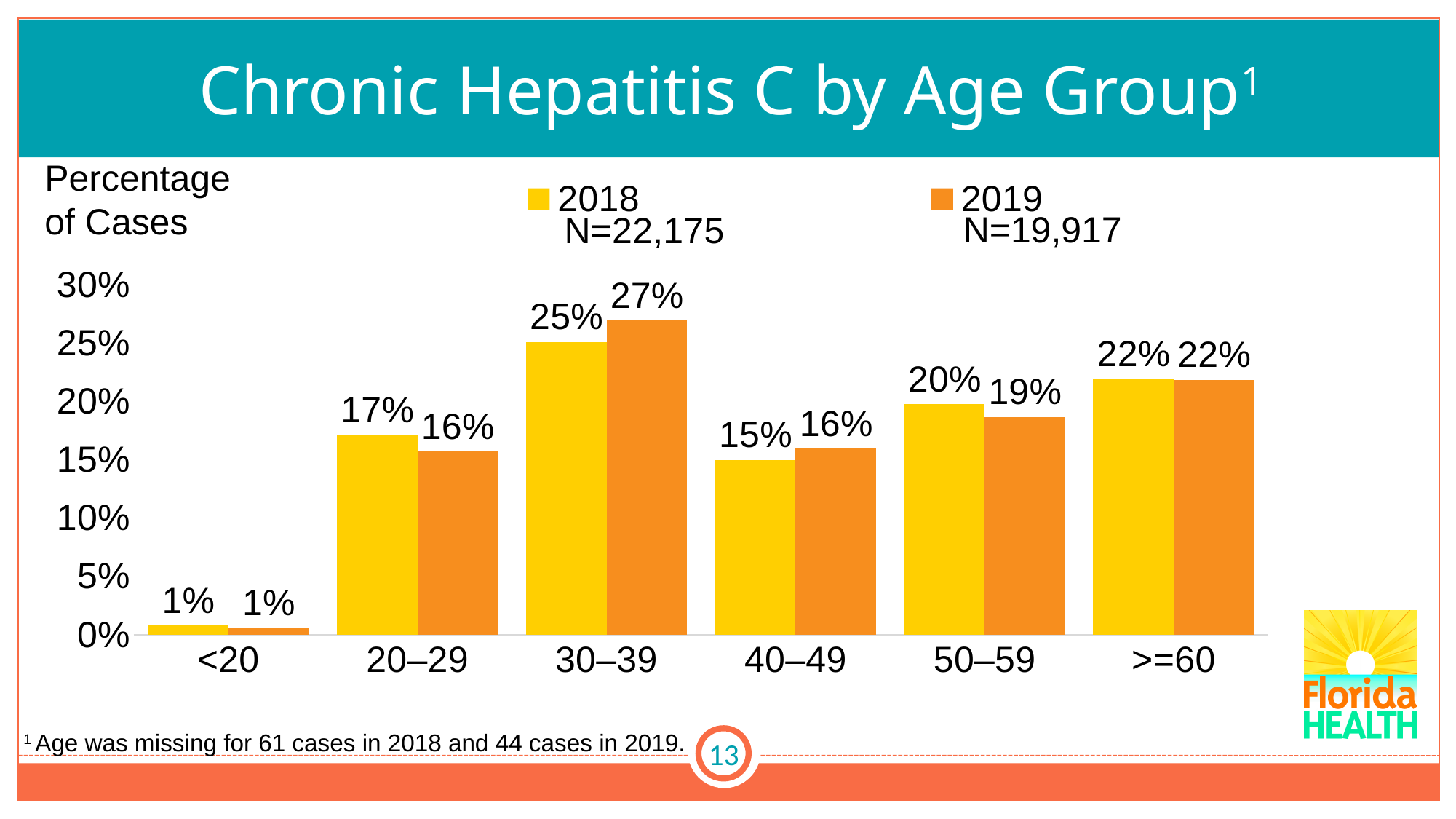
What is the difference between the 2019 and 2018 percentages for the 30–39 age group? 2% What percentage of cases were in the 50–59 age group in 2018? 20% What percentage of cases were in the 20–29 age group in 2019? 16% What kind of chart is shown on the slide? Bar chart What percentage of cases were in the 30–39 age group in 2019? 27% Which year had a higher percentage of cases in the 20–29 age group, 2018 or 2019? 2018 What is the N value shown in the legend for 2018? N=22,175 How many age groups are shown on the x axis? 6 Which age group had the lowest percentage of cases in 2019? <20 Which age group had the highest percentage of cases in 2018? 30–39 Is the 2018 value for the 40–49 age group greater or less than 20%? less How many series does the legend list? 2